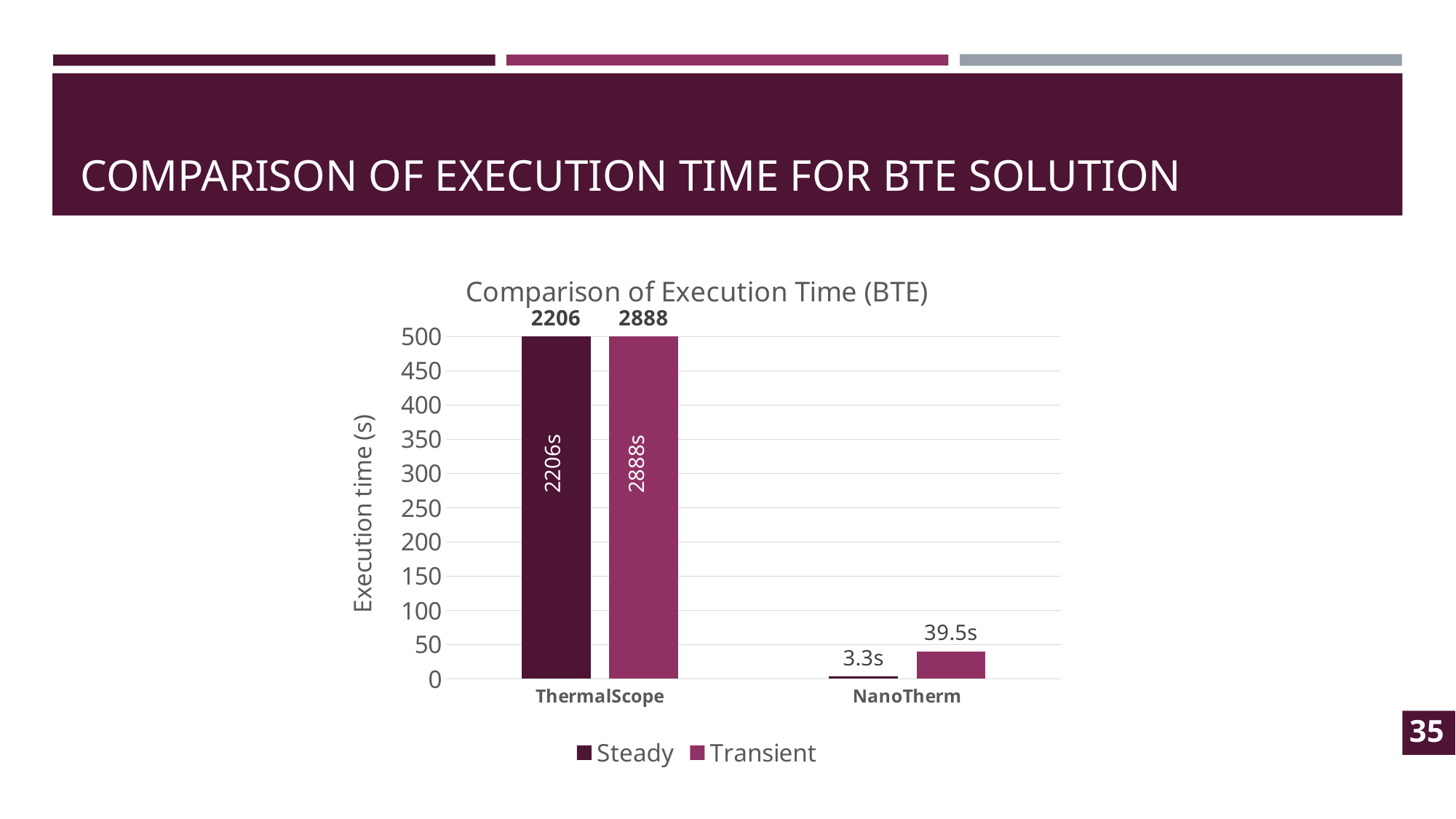
What is the Steady execution time for ThermalScope? 2206s What is the Steady execution time for NanoTherm? 3.3s Which is larger for NanoTherm, the Steady or the Transient execution time? Transient Which category has the lowest Steady execution time? NanoTherm How many series does the legend list? 2 How many categories are shown on the x axis? 2 What is the Transient execution time for ThermalScope? 2888s What kind of chart is shown on the slide? Bar chart What is the Transient execution time for NanoTherm? 39.5s Which category has the highest Transient execution time? ThermalScope What is the difference between the Transient and Steady execution times for NanoTherm? 36.2s What is the difference between the Transient and Steady execution times for ThermalScope? 682s